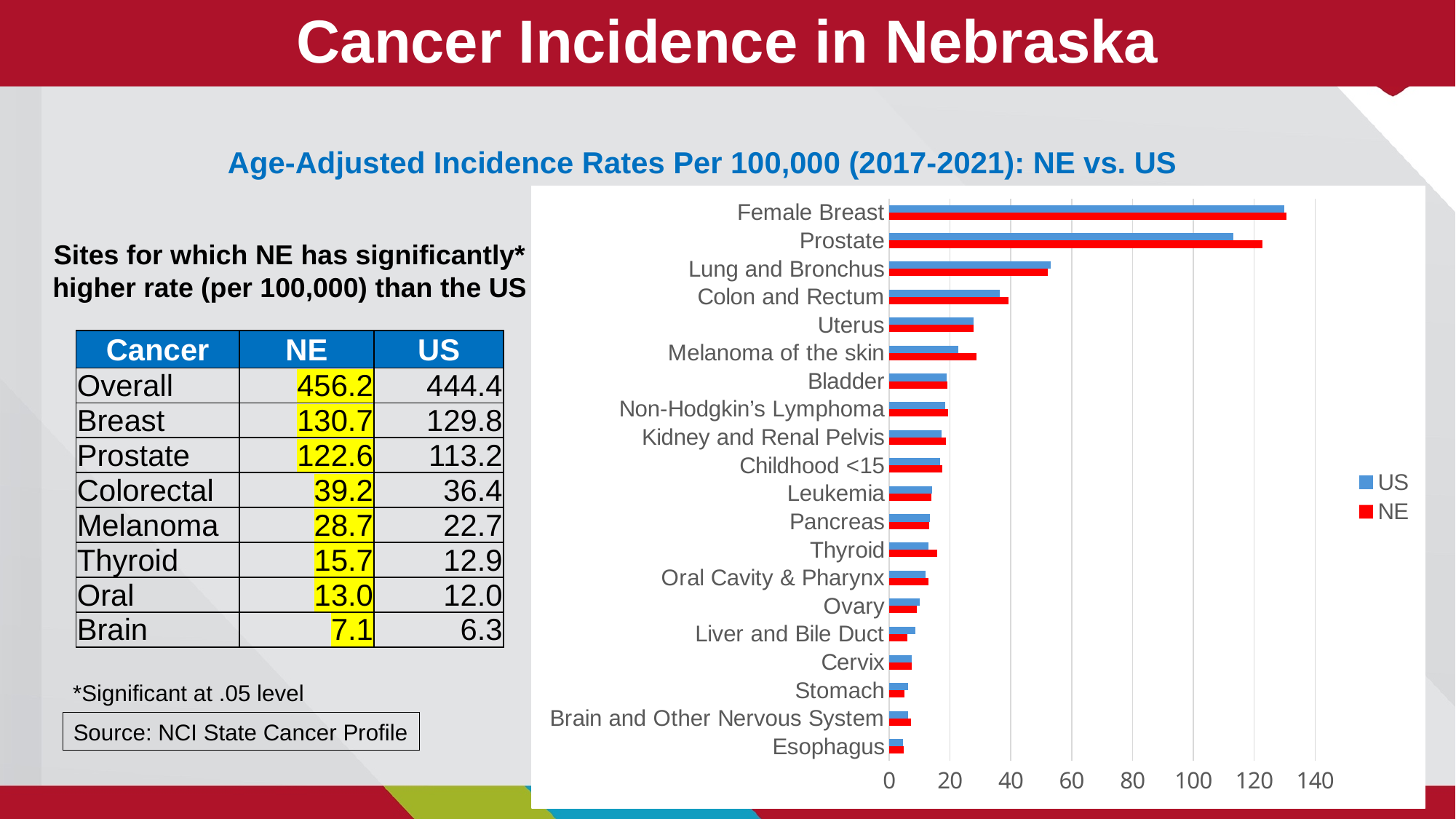
Is the NE value for Female Breast greater or less than 120? greater For Melanoma of the skin, which is larger, the NE value or the US value? NE Is the NE value for Uterus greater or less than 40? less Which cancer site has the highest incidence rate on the chart? Female Breast What colour represents NE in the chart legend? red How many series does the chart legend list? 2 Is the US value for Prostate greater or less than 100? greater What kind of chart is shown on the slide? bar chart Which cancer site has the lowest incidence rate on the chart? Esophagus How many cancer sites are plotted on the chart? 20 Going from the top of the chart to the bottom, do the bars get longer or shorter? shorter For Prostate, is the NE bar or the US bar longer? NE